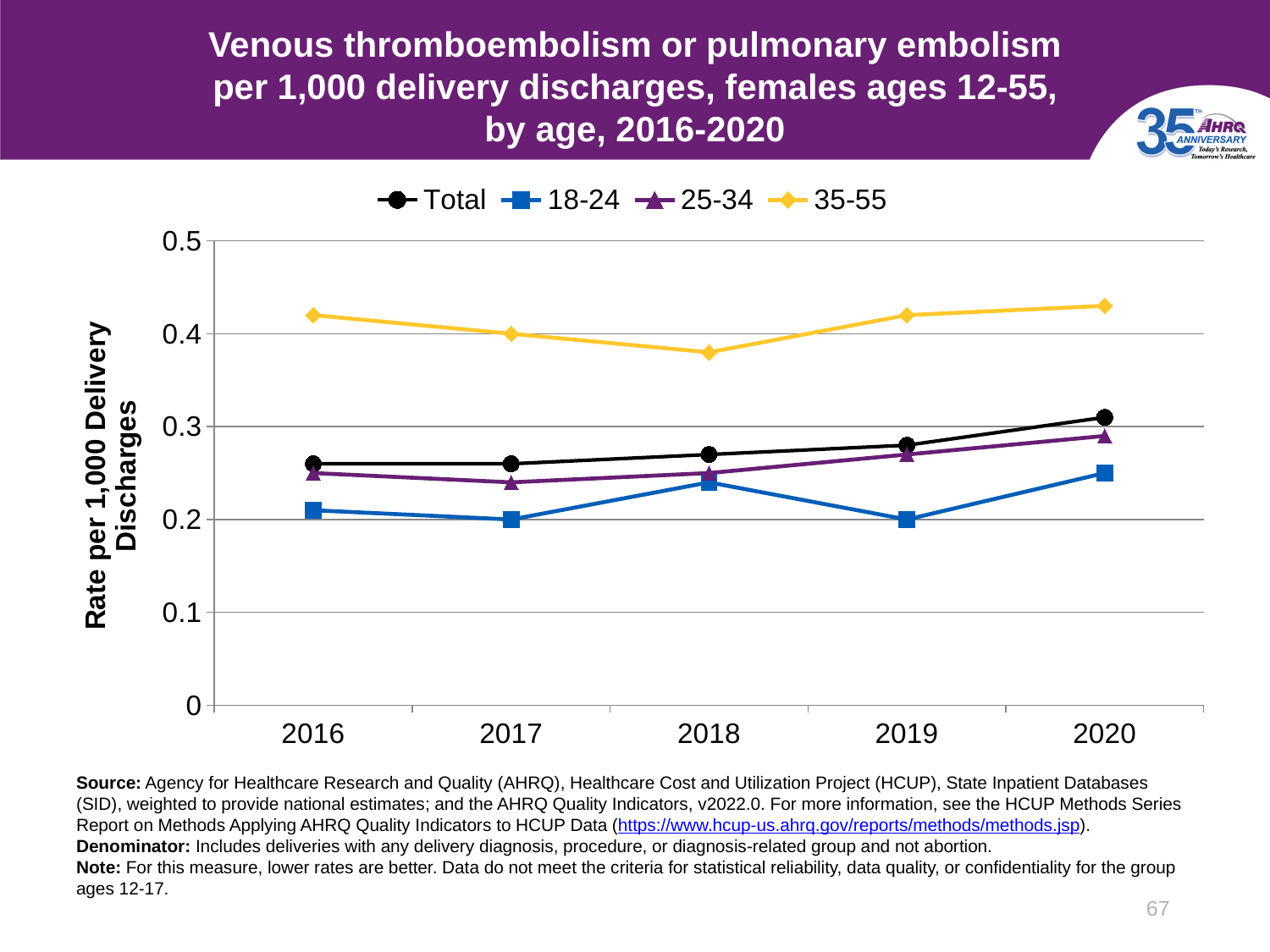
Is the value for the 35-55 group in 2016 greater or less than 0.4? greater What kind of chart is shown on the slide? line chart Which is larger, the Total rate in 2016 or the Total rate in 2020? 2020 In which year is the Total rate highest? 2020 In which year is the rate for the 35-55 group lowest? 2018 Which age group has the lowest rate in 2019? 18-24 How many series does the legend list? 4 Does the Total rate rise or fall from 2016 to 2020? rise How many years are plotted along the x axis? 5 Is the value for the 35-55 group in 2018 greater or less than 0.4? less Which age group has the highest rate in 2020? 35-55 Is the Total value in 2020 greater or less than 0.3? greater